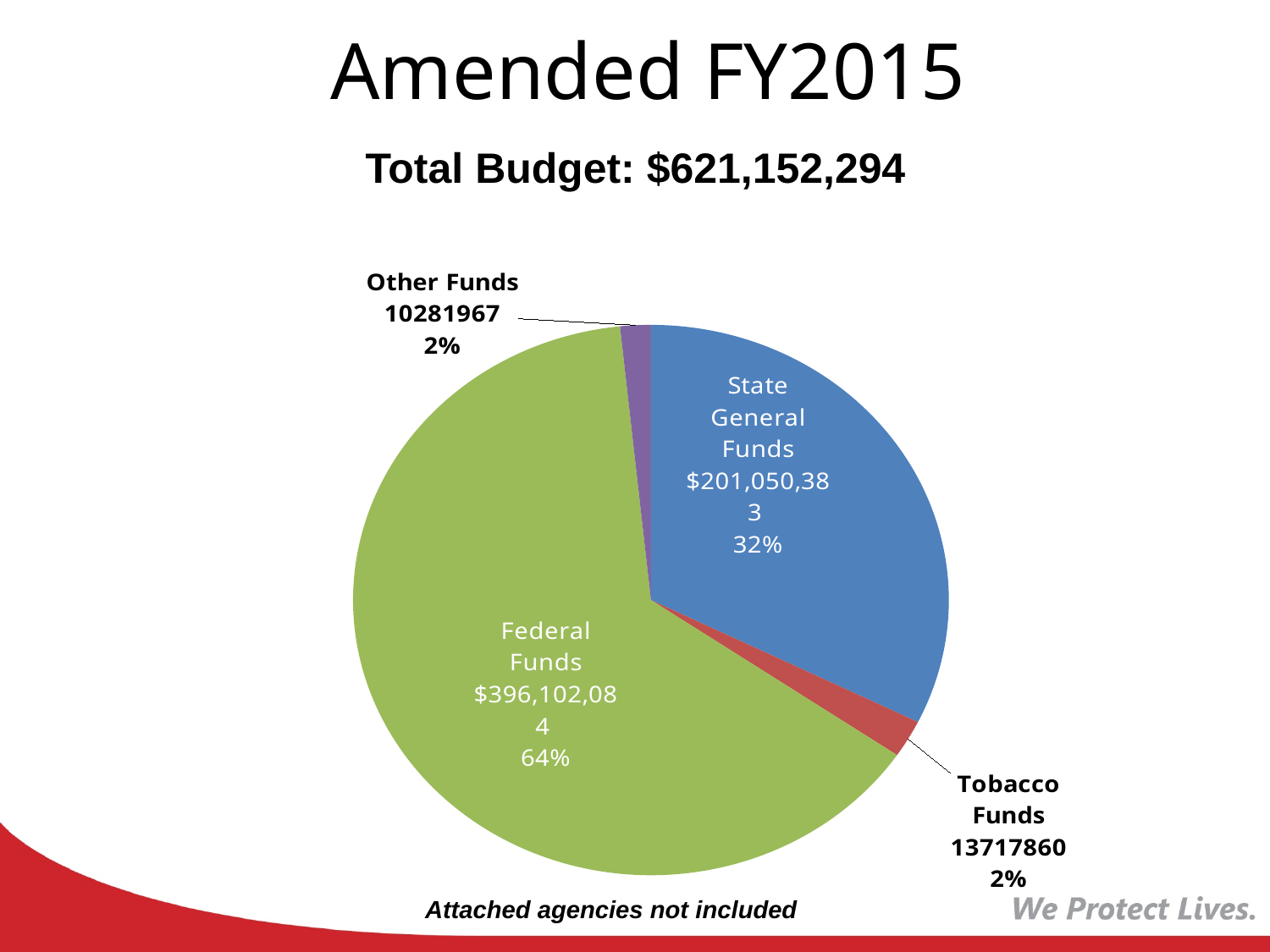
Which is larger, Federal Funds or State General Funds? Federal Funds What is the value shown for Tobacco Funds? 13717860 What is the difference between Federal Funds and State General Funds? $195,051,701 What is the value shown for State General Funds? $201,050,383 What share of the pie is Federal Funds? 64% What is the value shown for Federal Funds? $396,102,084 Which slice of the pie is the largest? Federal Funds What is the value shown for Other Funds? 10281967 How many slices does the pie chart have? 4 Which slice of the pie is the smallest? Other Funds What type of chart is shown on the slide? pie chart What share of the pie is State General Funds? 32%